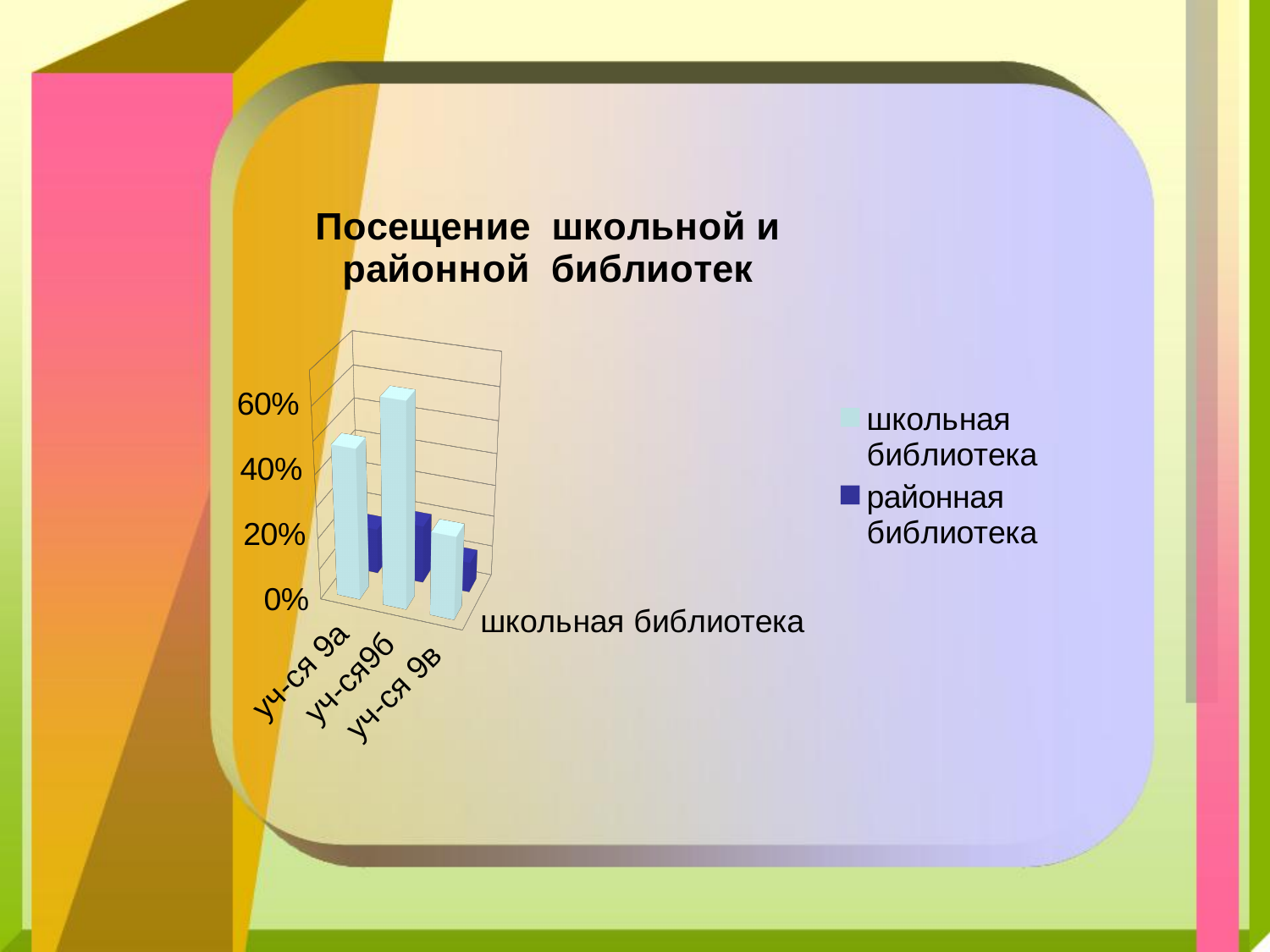
Is the value for школьная библиотека for уч-ся 9а greater or less than 20%? greater Is the value for школьная библиотека for уч-ся 9б greater or less than 40%? greater What is the title of the chart? Посещение школьной и районной библиотек For уч-ся 9б, which series has the larger value: школьная библиотека or районная библиотека? школьная библиотека Which category has the highest value for школьная библиотека? уч-ся 9б Is the value for школьная библиотека for уч-ся 9в greater or less than 40%? less Which is larger for школьная библиотека: уч-ся 9а or уч-ся 9в? уч-ся 9а How many categories are shown on the x axis of the chart? 3 Which series is shown in dark blue in the legend? районная библиотека What kind of chart is shown on the slide? bar chart Which category has the lowest value for школьная библиотека? уч-ся 9в How many series does the legend list? 2